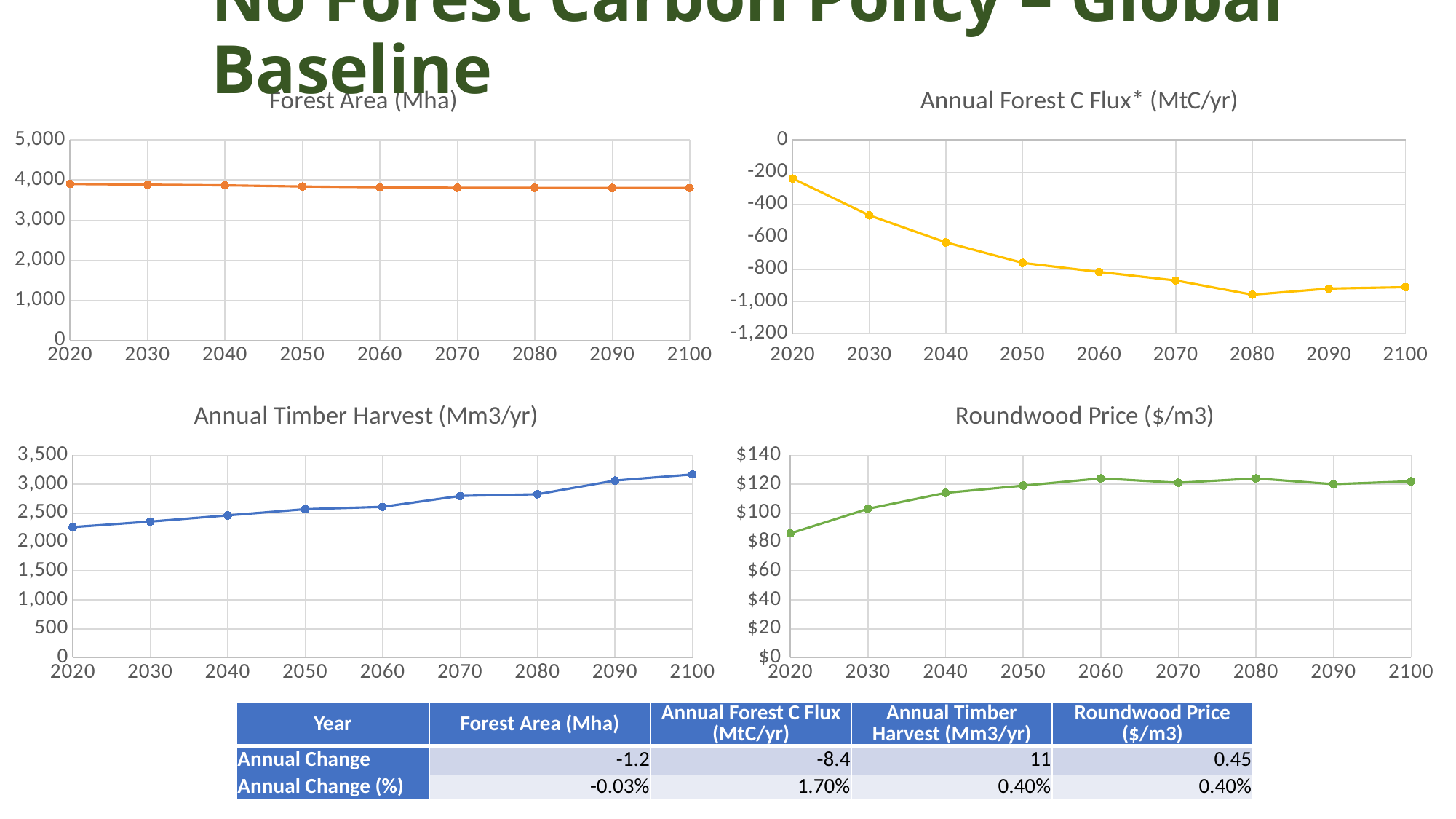
In the Roundwood Price ($/m3) chart, which year has the lowest value? 2020 In the Annual Forest C Flux* (MtC/yr) chart, is the value for 2050 greater or less than -600? less How many charts are shown on the slide? 4 In the Annual Forest C Flux* (MtC/yr) chart, which year has the lowest value? 2080 In the Forest Area (Mha) chart, is the value for 2020 greater or less than 3,000? greater What kind of chart is the Forest Area (Mha) chart? line chart In the Annual Timber Harvest (Mm3/yr) chart, do the values rise or fall from 2020 to 2100? rise In the Annual Forest C Flux* (MtC/yr) chart, which year has the highest value? 2020 In the Roundwood Price ($/m3) chart, is the value for 2020 greater or less than $100? less In the Annual Timber Harvest (Mm3/yr) chart, which is larger, the value for 2020 or the value for 2100? 2100 In the Annual Timber Harvest (Mm3/yr) chart, how many data points are plotted? 9